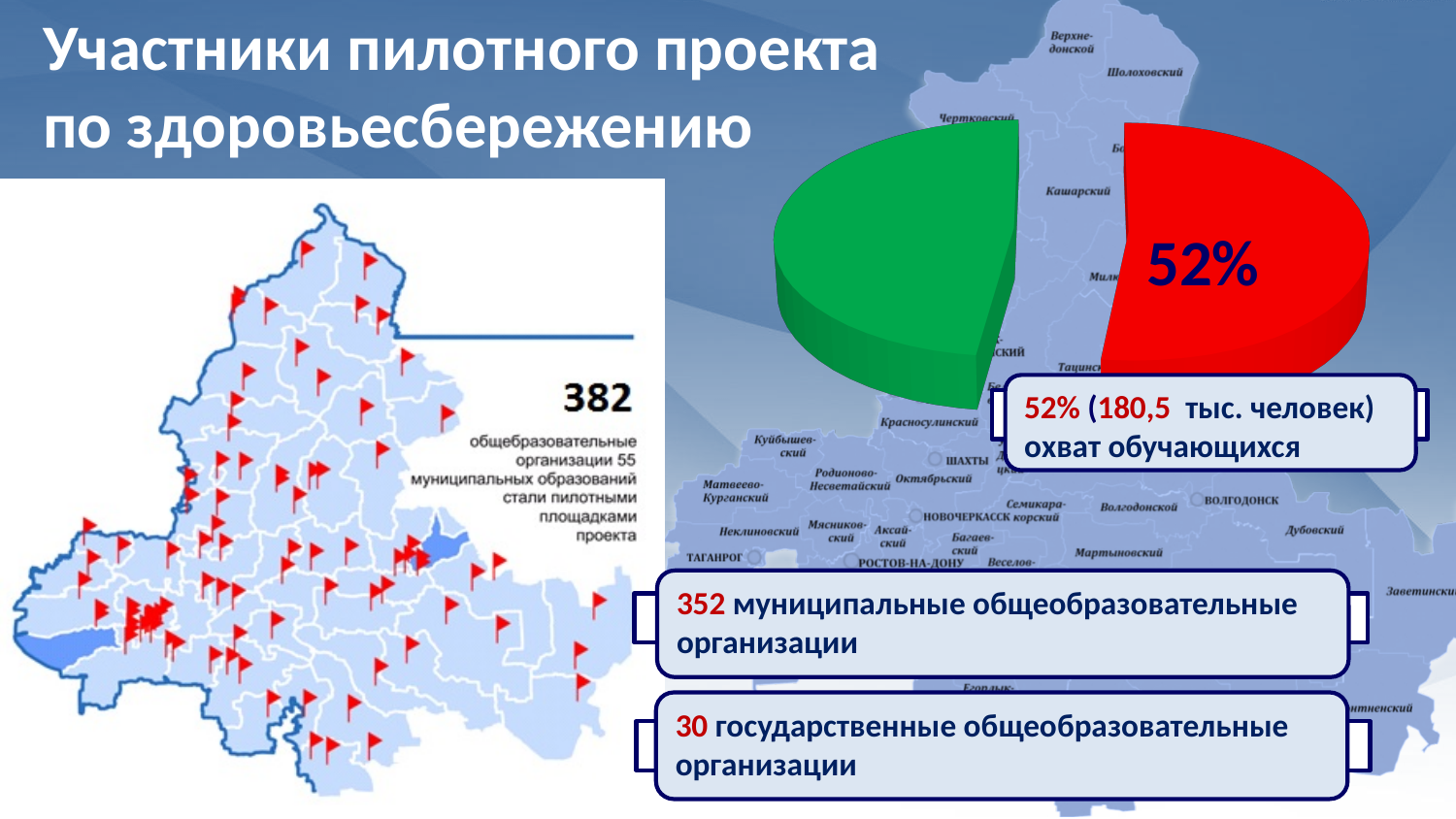
What kind of chart is shown on the slide? pie chart What share of the pie does the red slice represent? 52% What percentage is printed on the red slice of the pie chart? 52% Is the share of the red slice greater or less than 50%? greater Which slice of the pie chart is larger, the red one or the green one? red According to the text box next to the pie chart, how many people does the 52% correspond to? 180,5 тыс. человек Which slice of the pie chart is the smallest? the green slice Which slice of the pie chart is the largest? the red slice (52%) What two colours are used for the slices of the pie chart? green and red How many slices does the pie chart have? 2